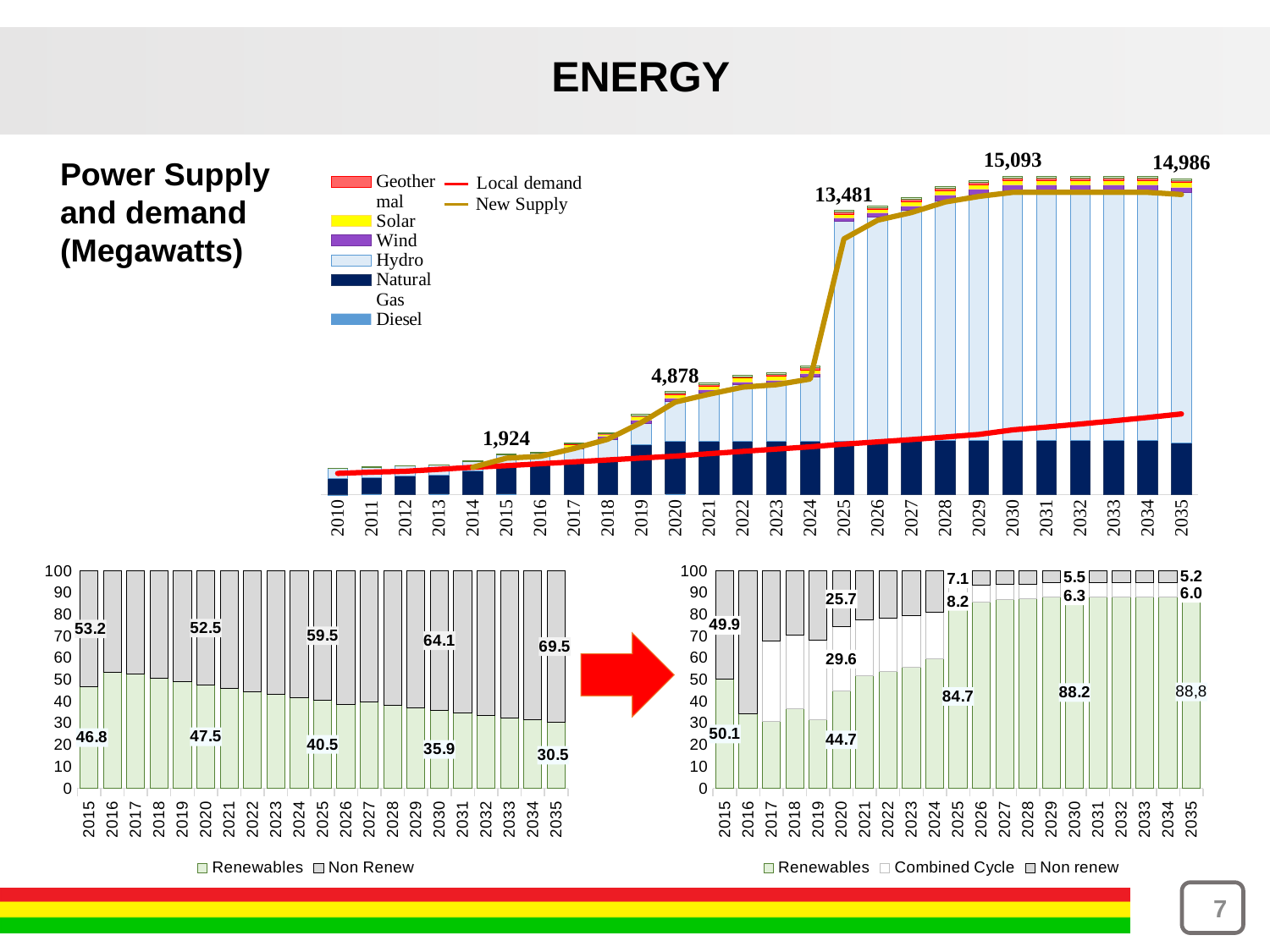
How many series does the legend of the bottom-right chart list? 3 In the top Power Supply and demand chart, what is the labelled value for 2035? 14,986 In the top Power Supply and demand chart, what is the labelled value for 2025? 13,481 In the bottom-left chart, what is the Renewables value for 2015? 46.8 In the bottom-right chart, what is the Renewables value for 2030? 88.2 In the bottom-right chart, what is the Combined Cycle value for 2020? 29.6 In the bottom-left chart, what is the Non Renew value for 2035? 69.5 How many years are shown on the x axis of the bottom-left chart? 21 What kind of chart is the bottom-left chart? stacked bar chart In the bottom-left chart, does the Renewables share rise or fall from 2015 to 2035? fall In the bottom-right chart, which is larger for 2015, Renewables or Non renew? Renewables In the bottom-left chart, what is the difference between the Non Renew and Renewables values for 2035? 39.0